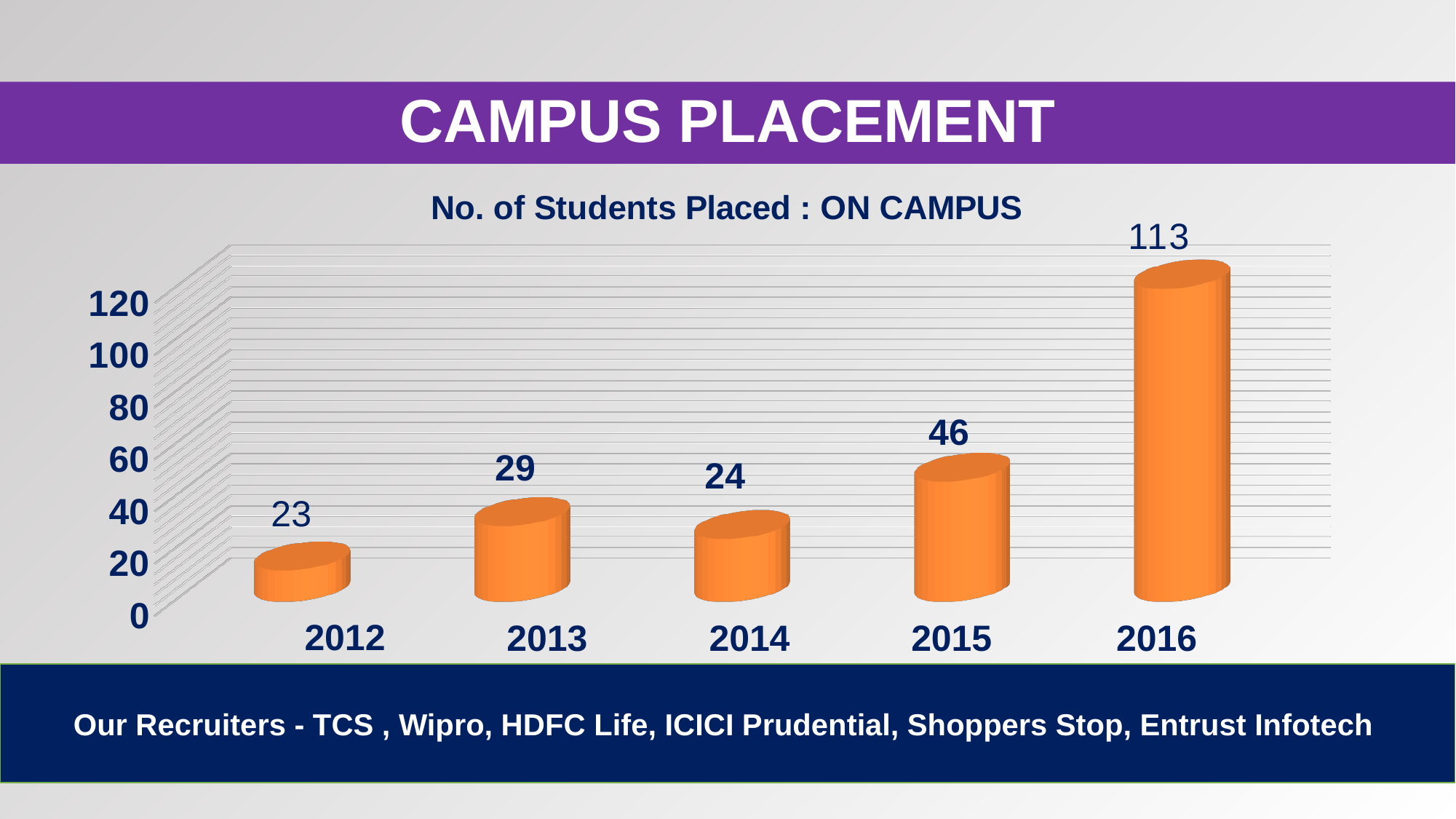
How many students were placed on campus in 2012? 23 What is the title of the chart? No. of Students Placed : ON CAMPUS What kind of chart is shown on the slide? bar chart Which year had more students placed, 2013 or 2014? 2013 How many years are shown on the x axis of the chart? 5 What is the number of students placed in 2015? 46 What value is shown for 2016? 113 Is the value for 2016 greater or less than 100? greater Which year has the highest number of students placed? 2016 Which year has the lowest number of students placed? 2012 What is the difference between the values for 2013 and 2014? 5 What is the difference between the number of students placed in 2016 and 2015? 67